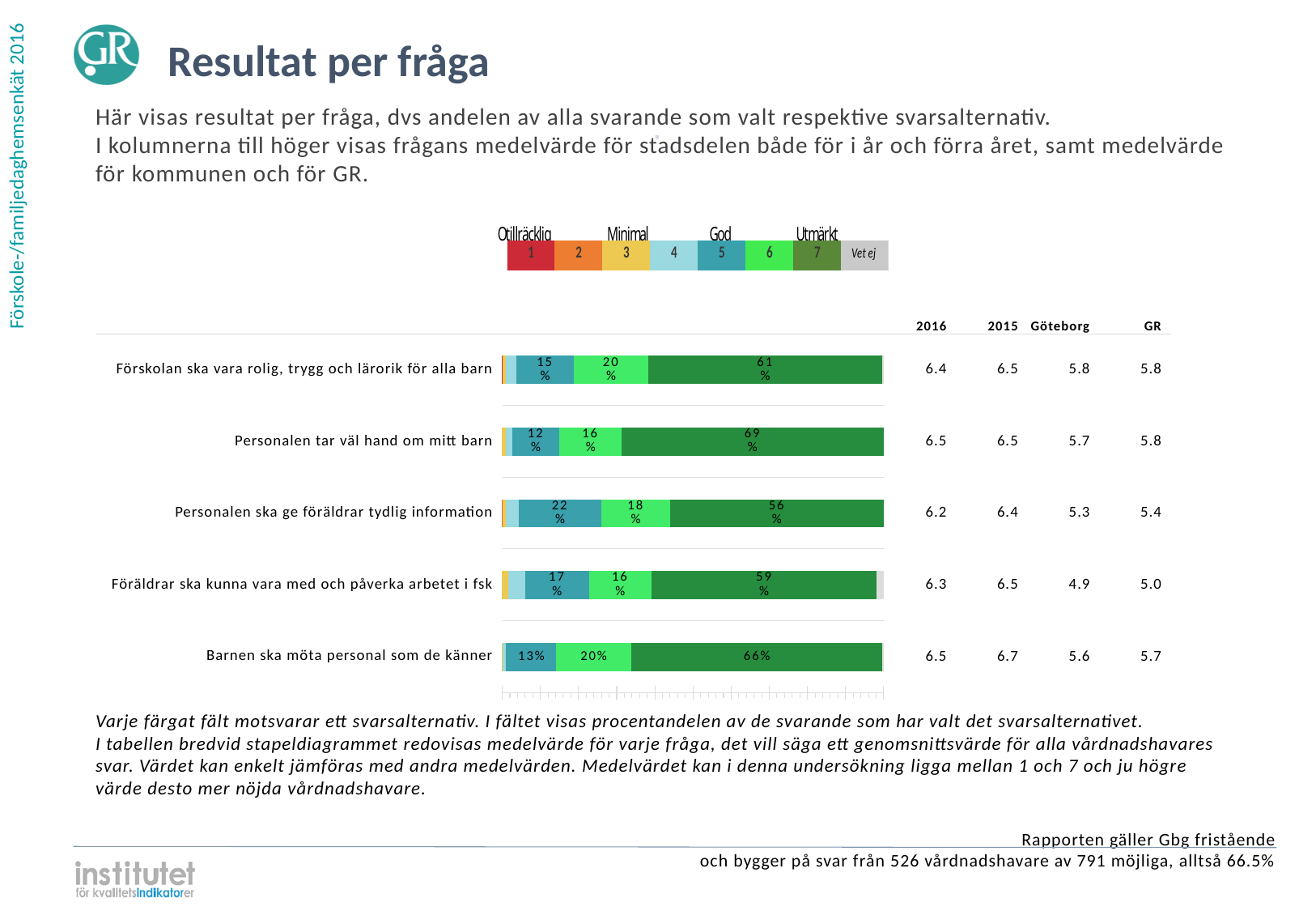
What percentage of respondents chose option 5 (teal) for "Personalen ska ge föräldrar tydlig information"? 22% What is the difference in percentage points between the option 7 share for "Personalen tar väl hand om mitt barn" and for "Förskolan ska vara rolig, trygg och lärorik för alla barn"? 8 What percentage of respondents chose option 6 (light green) for "Barnen ska möta personal som de känner"? 20% What type of chart is used to show the results per question? Stacked bar chart What percentage of respondents chose option 7 (dark green) for "Föräldrar ska kunna vara med och påverka arbetet i fsk"? 59% Which question has the highest share of respondents choosing option 7 (dark green)? Personalen tar väl hand om mitt barn Which has a larger option 5 (teal) share: "Personalen ska ge föräldrar tydlig information" or "Personalen tar väl hand om mitt barn"? Personalen ska ge föräldrar tydlig information Which question has the lowest share of respondents choosing option 7 (dark green)? Personalen ska ge föräldrar tydlig information Which label in the legend corresponds to answer option 7? Utmärkt What percentage of respondents chose option 7 (dark green) for "Personalen tar väl hand om mitt barn"? 69% What is the 2016 mean value shown for "Personalen ska ge föräldrar tydlig information"? 6.2 How many questions (bars) are shown in the chart? 5